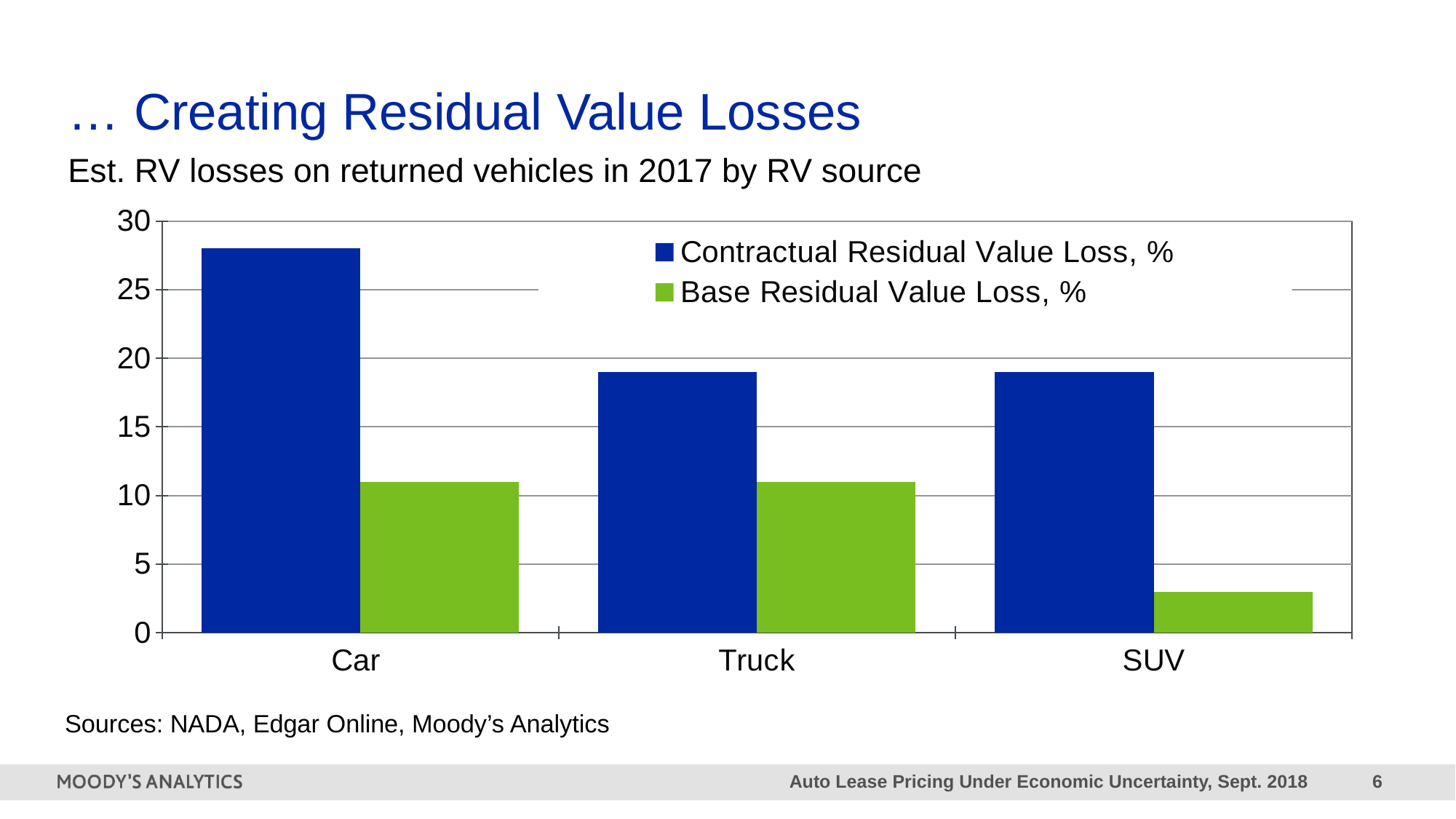
What colour are the bars for Base Residual Value Loss, %? green Is the Base Residual Value Loss, % for Car greater or less than 15? less Which is larger: the Base Residual Value Loss, % for Truck or for SUV? Truck Which vehicle category has the lowest Base Residual Value Loss, %? SUV Which vehicle category has the highest Contractual Residual Value Loss, %? Car How many vehicle categories are shown on the x axis? 3 Which is larger: the Contractual Residual Value Loss, % for Car or for Truck? Car Is the Contractual Residual Value Loss, % for Car greater or less than 25? greater Is the Contractual Residual Value Loss, % for Truck greater or less than 15? greater How many series does the legend list? 2 What kind of chart is shown on the slide? bar chart